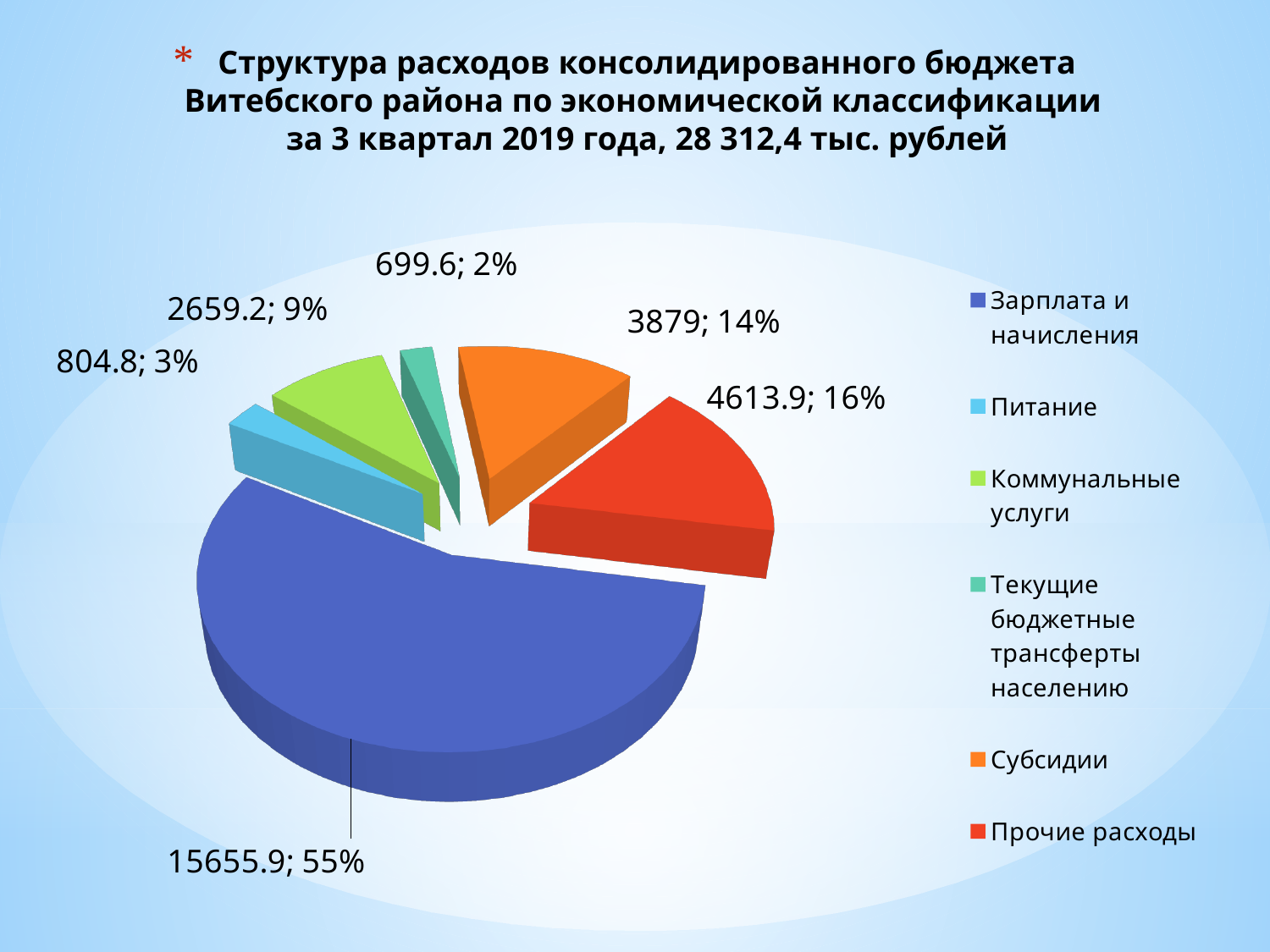
What share of the pie does Субсидии take? 14% What is the difference between the values for Прочие расходы and Субсидии? 734.9 How many entries does the legend list? 6 What value is shown for Коммунальные услуги? 2659.2 Which category has the smallest slice? Текущие бюджетные трансферты населению What value is shown for Зарплата и начисления? 15655.9 Which category has the largest slice? Зарплата и начисления What kind of chart is shown on the slide? pie chart What value is shown for Прочие расходы? 4613.9 Which is larger, Субсидии or Прочие расходы? Прочие расходы How many slices does the pie chart have? 6 What share of the pie does Зарплата и начисления take? 55%